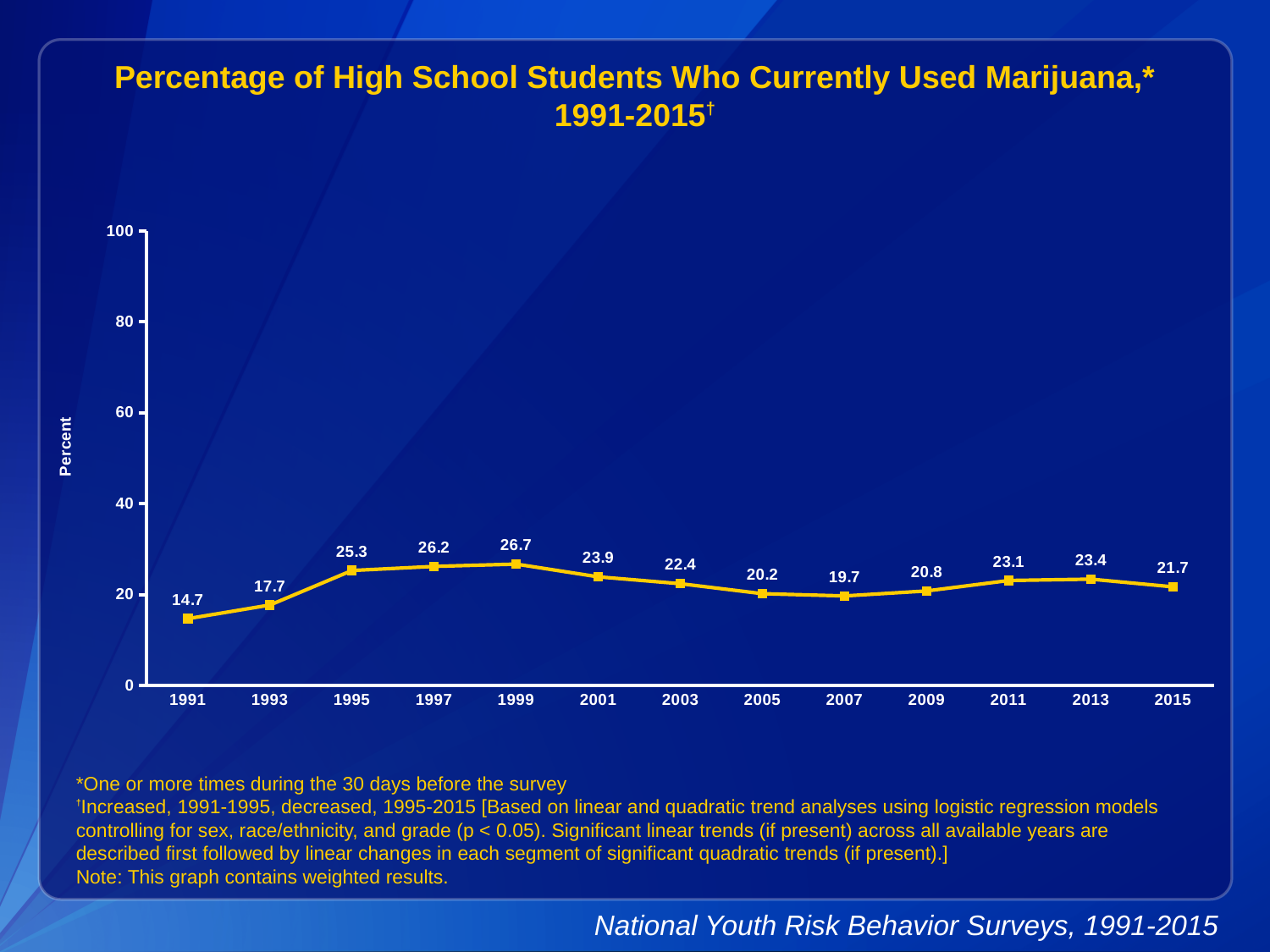
What is the value plotted for 2007? 19.7 What percentage of high school students currently used marijuana in 1991? 14.7 Do the values rise or fall from 1991 to 1995? rise How many years are plotted on the chart? 13 What is the difference between the 2013 value and the 2015 value? 1.7 What is the value plotted for 2015? 21.7 What kind of chart is shown on the slide? line chart Which year has the highest percentage? 1999 Is the value for 1997 greater or less than 40? less Which is larger, the value for 1995 or the value for 2011? 1995 What is the difference between the 1999 value and the 1991 value? 12 Which year has the lowest percentage? 1991